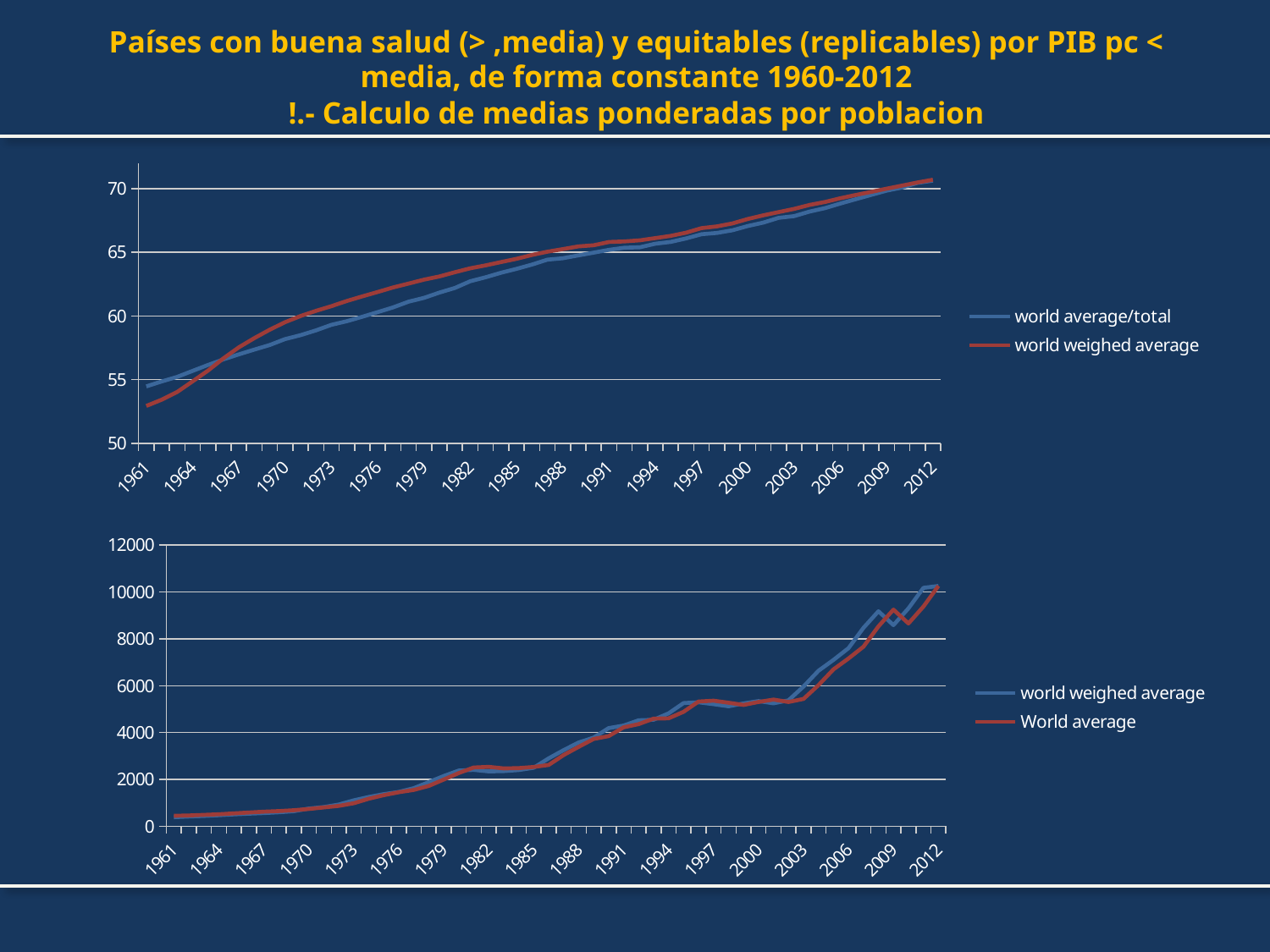
In the bottom chart, is the value for World average in 1961 greater or less than 2000? less In the bottom chart, is the value for world weighed average in 2006 greater or less than 6000? greater In the top chart, do the values generally rise or fall from 1961 to 2012? rise In the bottom chart, do the values generally rise or fall from 1961 to 2012? rise How many series does the legend of the top chart list? 2 What kind of chart is the top chart on the slide? line chart How many series does the legend of the bottom chart list? 2 In the bottom chart, which series is drawn in red? World average In the top chart, is the value for world weighed average in 1961 greater or less than 55? less In the top chart, what are the two legend entries? world average/total; world weighed average What kind of chart is the bottom chart on the slide? line chart